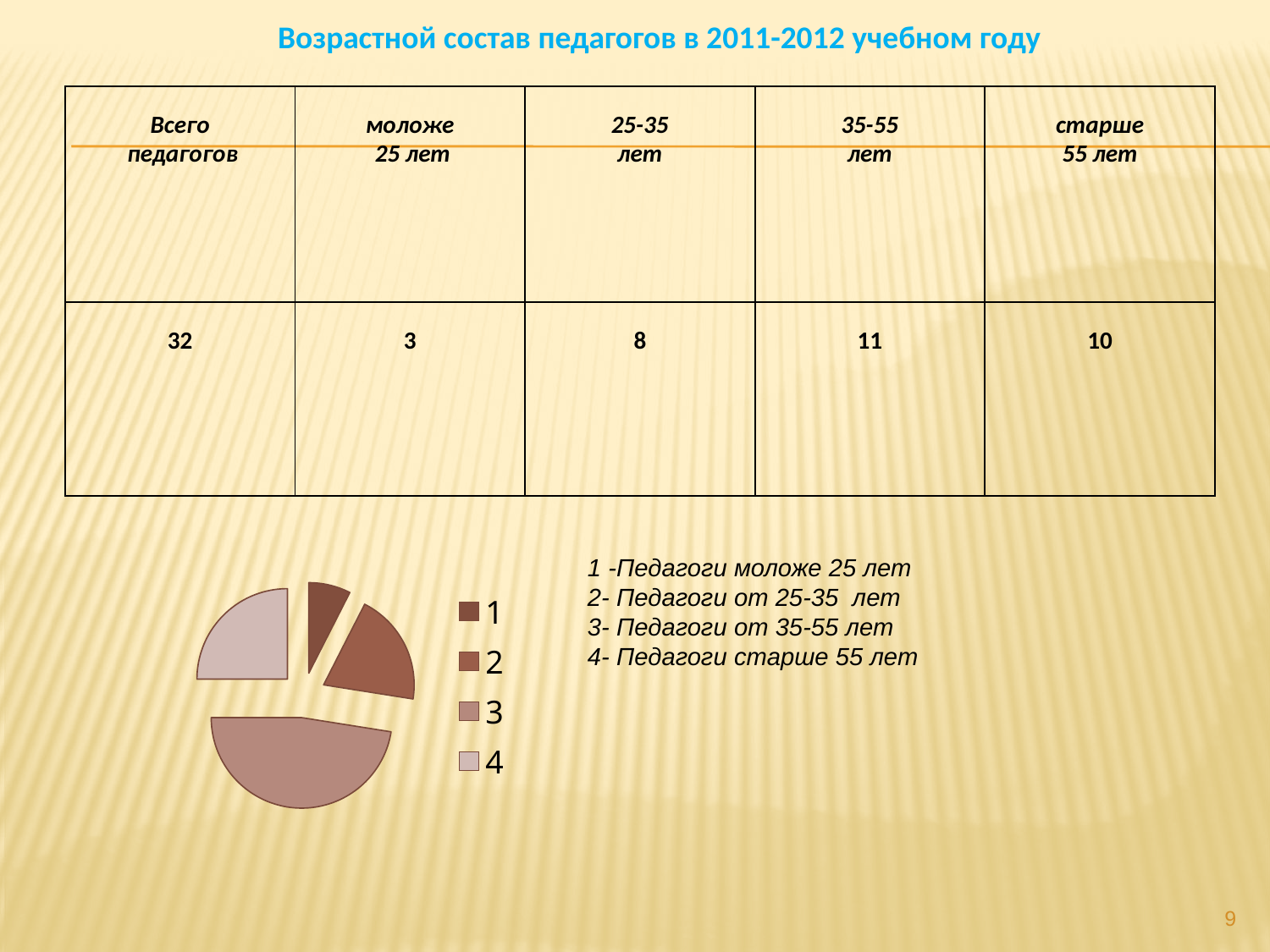
What kind of chart is shown on the slide? pie chart According to the slide, what does legend entry 1 of the pie chart represent? Педагоги моложе 25 лет According to the table on the slide, how many teachers are in the group shown as slice 3 (35-55 лет)? 11 Which slice of the pie chart is the smallest? 1 According to the table on the slide, what is the total number of teachers represented by the pie chart? 32 Which slice of the pie chart is larger, slice 2 or slice 4? 4 Which slice of the pie chart is the largest? 3 How many slices does the pie chart have? 4 According to the table on the slide, how many teachers are in the group shown as slice 1 (моложе 25 лет)? 3 According to the table on the slide, what is the difference between the number of teachers aged 35-55 and those aged 25-35? 3 According to the slide, what does legend entry 3 of the pie chart represent? Педагоги от 35-55 лет How many entries does the pie chart's legend list? 4